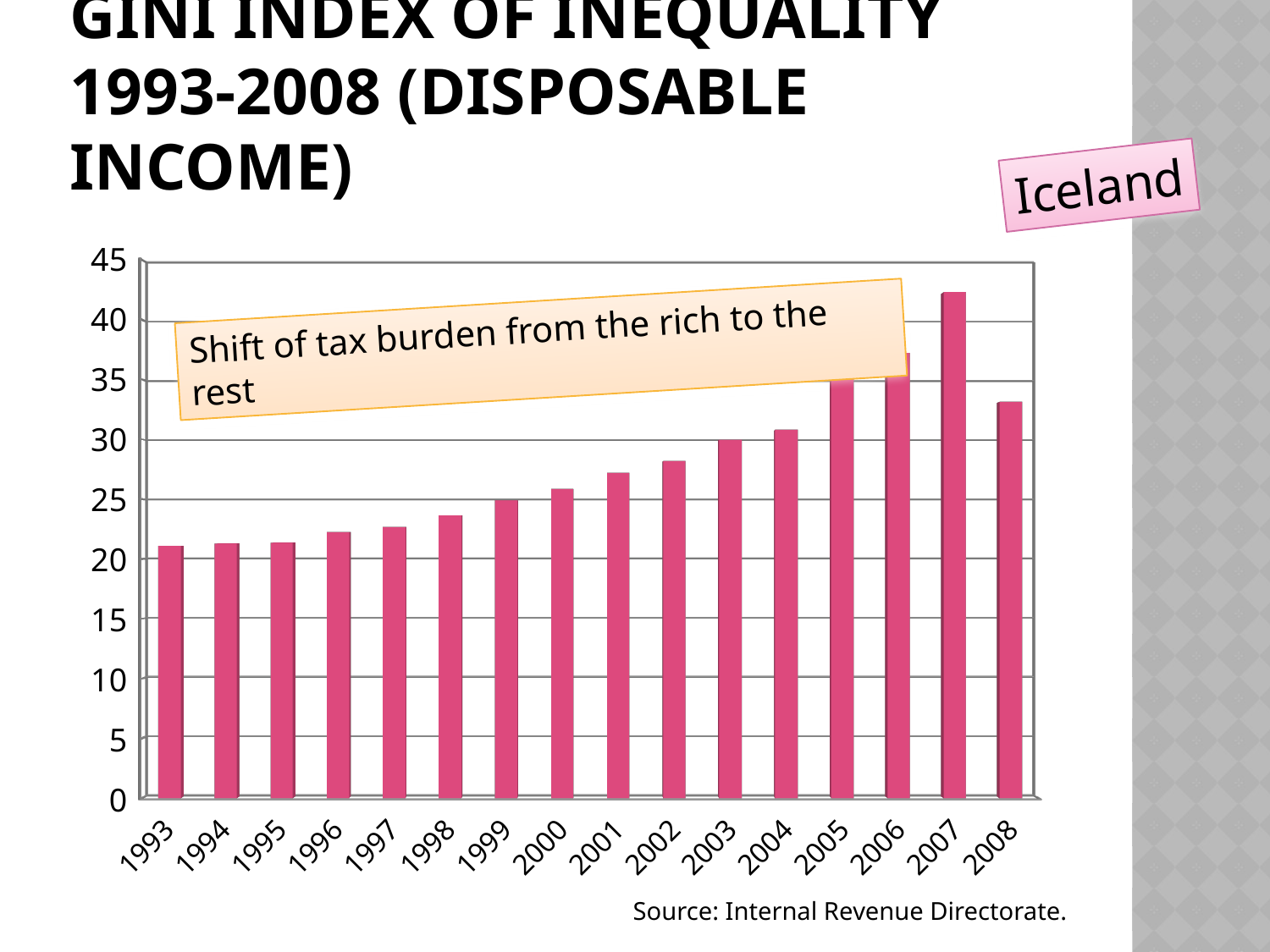
Which is larger, the value for 2007 or the value for 2008? 2007 Do the values generally rise or fall from 1993 to 2007? Rise Is the value for 2008 greater or less than 30? greater Is the value for 2007 greater or less than 40? greater What source is cited below the chart? Internal Revenue Directorate What kind of chart is shown on the slide? Bar chart Is the value for 2006 greater or less than 35? greater Which year has the highest Gini index value? 2007 What does the annotation box on the chart say? Shift of tax burden from the rich to the rest How many years (bars) are plotted on the chart? 16